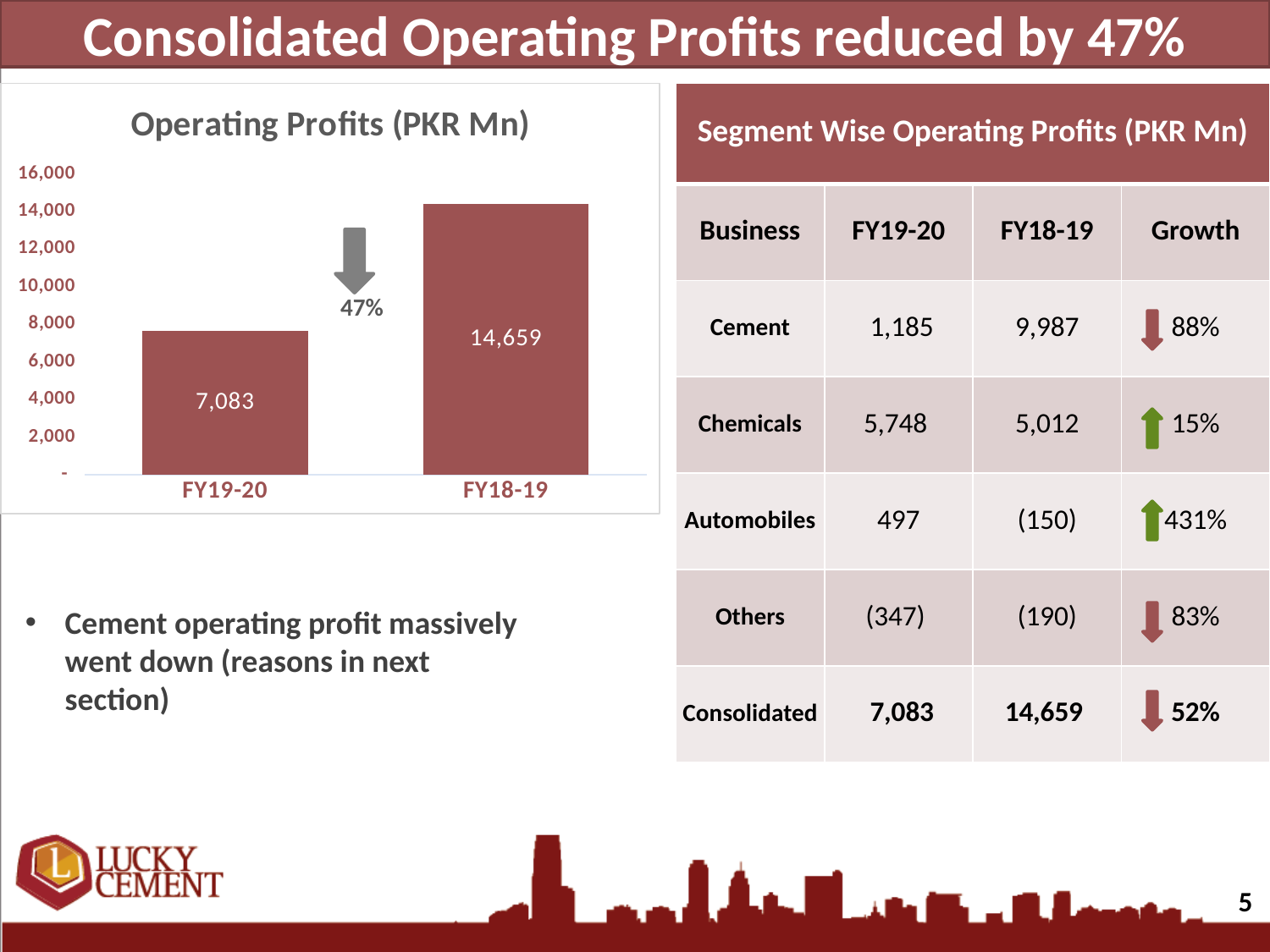
What percentage change is annotated between the two bars in the Operating Profits (PKR Mn) chart? 47% What is the difference between the FY18-19 and FY19-20 values in the Operating Profits (PKR Mn) chart? 7,576 Which category has the highest value in the Operating Profits (PKR Mn) chart? FY18-19 What is the value for FY18-19 in the Operating Profits (PKR Mn) chart? 14,659 In the Operating Profits (PKR Mn) chart, which is larger: FY19-20 or FY18-19? FY18-19 What is the title of the chart on the left of the slide? Operating Profits (PKR Mn) What kind of chart is the Operating Profits (PKR Mn) chart? bar chart Is the value for FY19-20 in the Operating Profits (PKR Mn) chart greater or less than 8,000? less How many categories are shown in the Operating Profits (PKR Mn) chart? 2 Is the value for FY18-19 in the Operating Profits (PKR Mn) chart greater or less than 14,000? greater Which category has the lowest value in the Operating Profits (PKR Mn) chart? FY19-20 What is the value for FY19-20 in the Operating Profits (PKR Mn) chart? 7,083